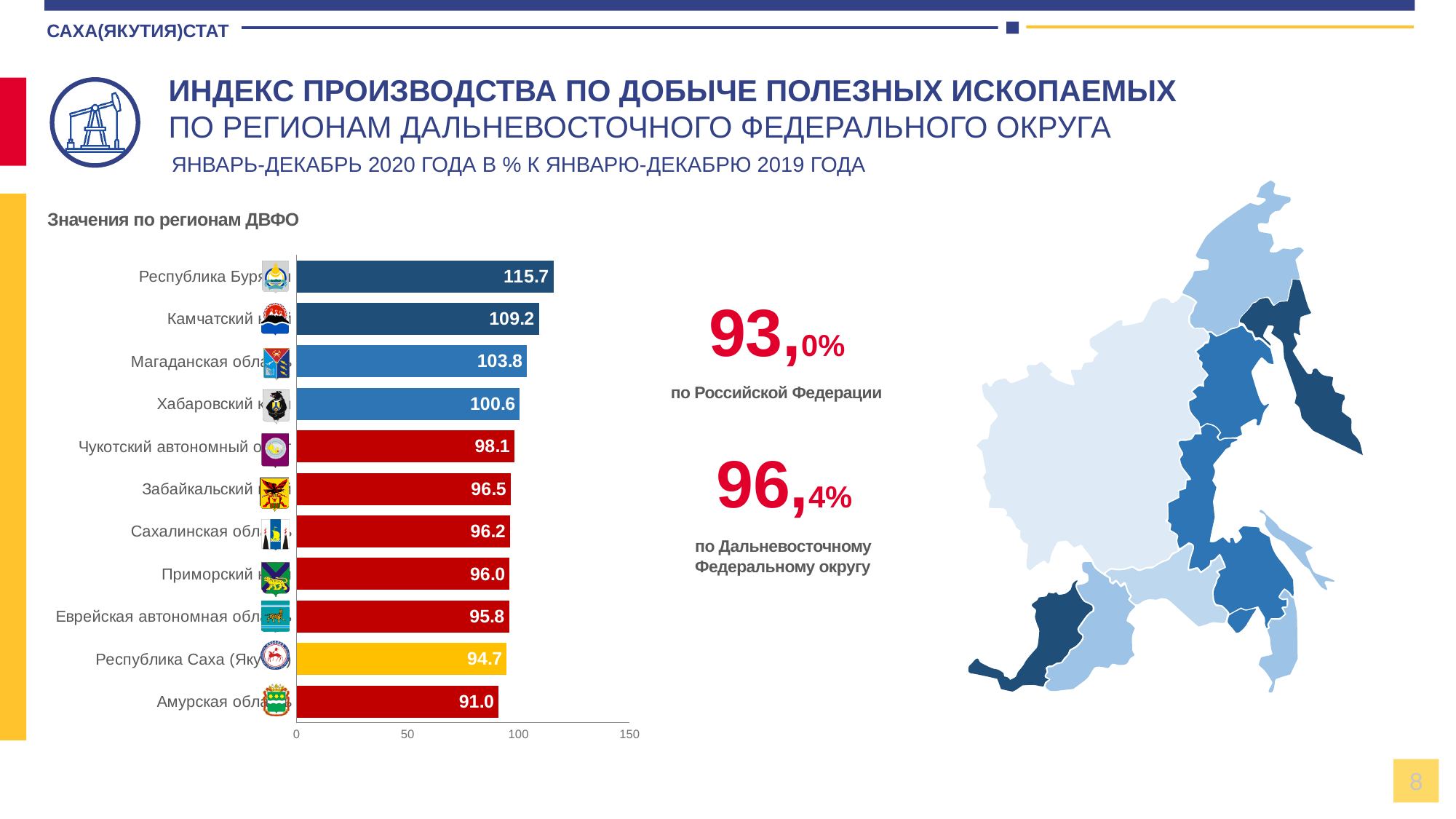
What is the value for Магаданская область? 103.8 What colour is the bar for Республика Саха (Якутия)? yellow Is the value for Чукотский автономный округ greater or less than 100? less How many regions are shown in the bar chart? 11 What is the difference between the values for Республика Бурятия and Амурская область? 24.7 What is the difference between the values for Камчатский край and Республика Саха (Якутия)? 14.5 What kind of chart is shown on the slide? bar chart What is the value for Республика Саха (Якутия)? 94.7 Which has a larger value, Камчатский край or Хабаровский край? Камчатский край Which region has the highest value in the chart? Республика Бурятия What is the value for Республика Бурятия? 115.7 Which region has the lowest value in the chart? Амурская область